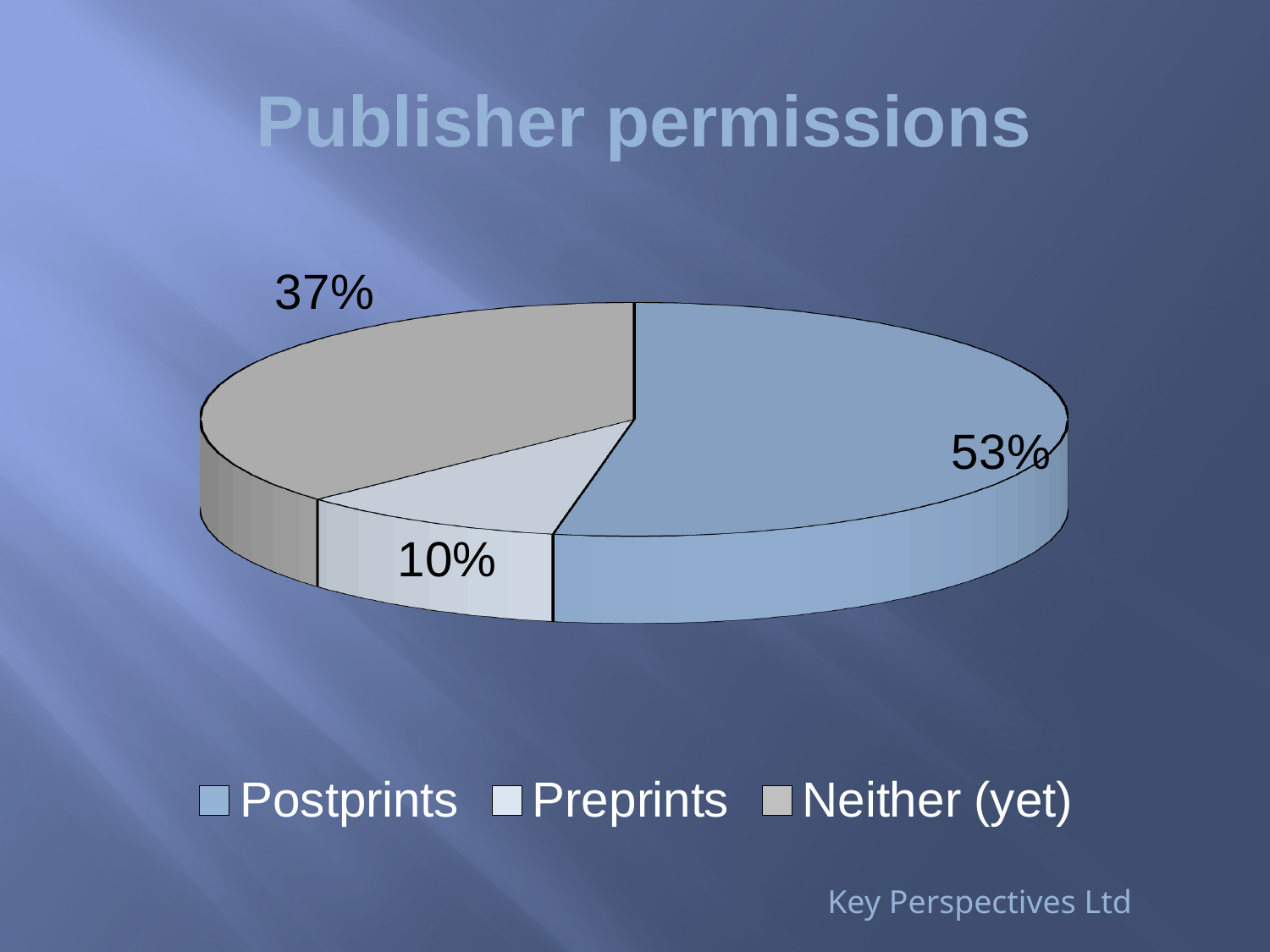
Which category has the smallest share of the pie? Preprints How many slices does the pie chart have? 3 What is the difference in percentage points between Postprints and Neither (yet)? 16 How many entries does the legend list? 3 Which category has the largest share of the pie? Postprints What percentage of the pie is Postprints? 53% What percentage of the pie is Neither (yet)? 37% Which is larger, the share for Preprints or the share for Neither (yet)? Neither (yet) What kind of chart is shown on the slide? pie chart What is the difference in percentage points between Neither (yet) and Preprints? 27 What is the title of the chart? Publisher permissions What percentage of the pie is Preprints? 10%